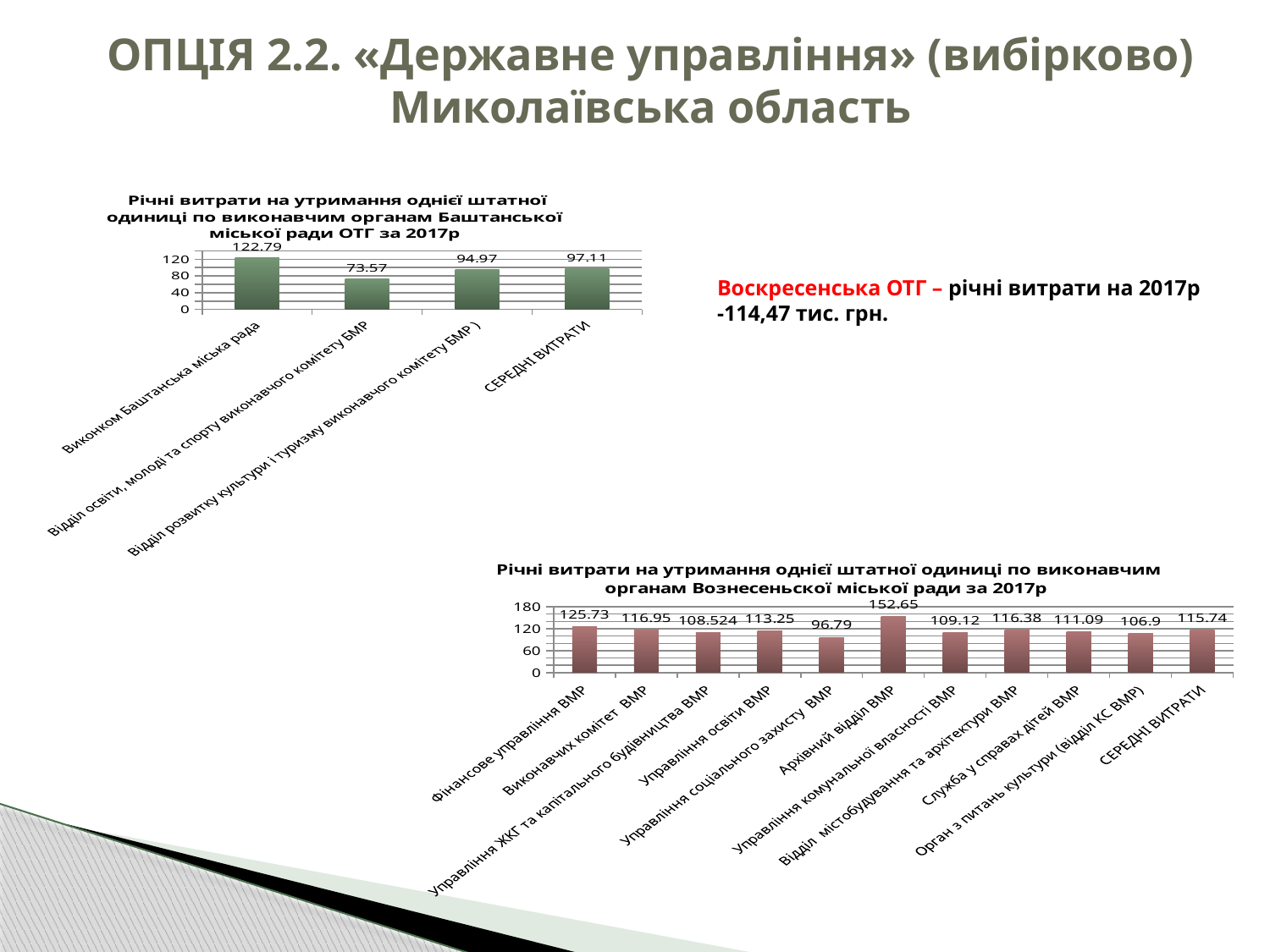
In the top-left chart (Баштанська міська рада ОТГ), which category has the lowest value? Відділ освіти, молоді та спорту виконавчого комітету БМР In the top-left chart (Баштанська міська рада ОТГ), what is the value for СЕРЕДНІ ВИТРАТИ? 97.11 In the bottom-right chart (Вознесеньської міської ради), which is larger: Фінансове управління ВМР or Виконавчих комітет ВМР? Фінансове управління ВМР In the top-left chart (Баштанська міська рада ОТГ), what is the value for Виконком Баштанська міська рада? 122.79 In the bottom-right chart (Вознесеньської міської ради), what is the value for Управління соціального захисту ВМР? 96.79 In the top-left chart (Баштанська міська рада ОТГ), what is the difference between Виконком Баштанська міська рада and Відділ освіти, молоді та спорту виконавчого комітету БМР? 49.22 What type of chart is the bottom-right chart (Вознесеньської міської ради)? Bar chart In the bottom-right chart (Вознесеньської міської ради), which category has the highest value? Архівний відділ ВМР In the bottom-right chart (Вознесеньської міської ради), what is the value for Архівний відділ ВМР? 152.65 How many bars are in the top-left chart (Баштанська міська рада ОТГ)? 4 How many bars are in the bottom-right chart (Вознесеньської міської ради)? 11 In the bottom-right chart (Вознесеньської міської ради), what is the difference between Архівний відділ ВМР and СЕРЕДНІ ВИТРАТИ? 36.91